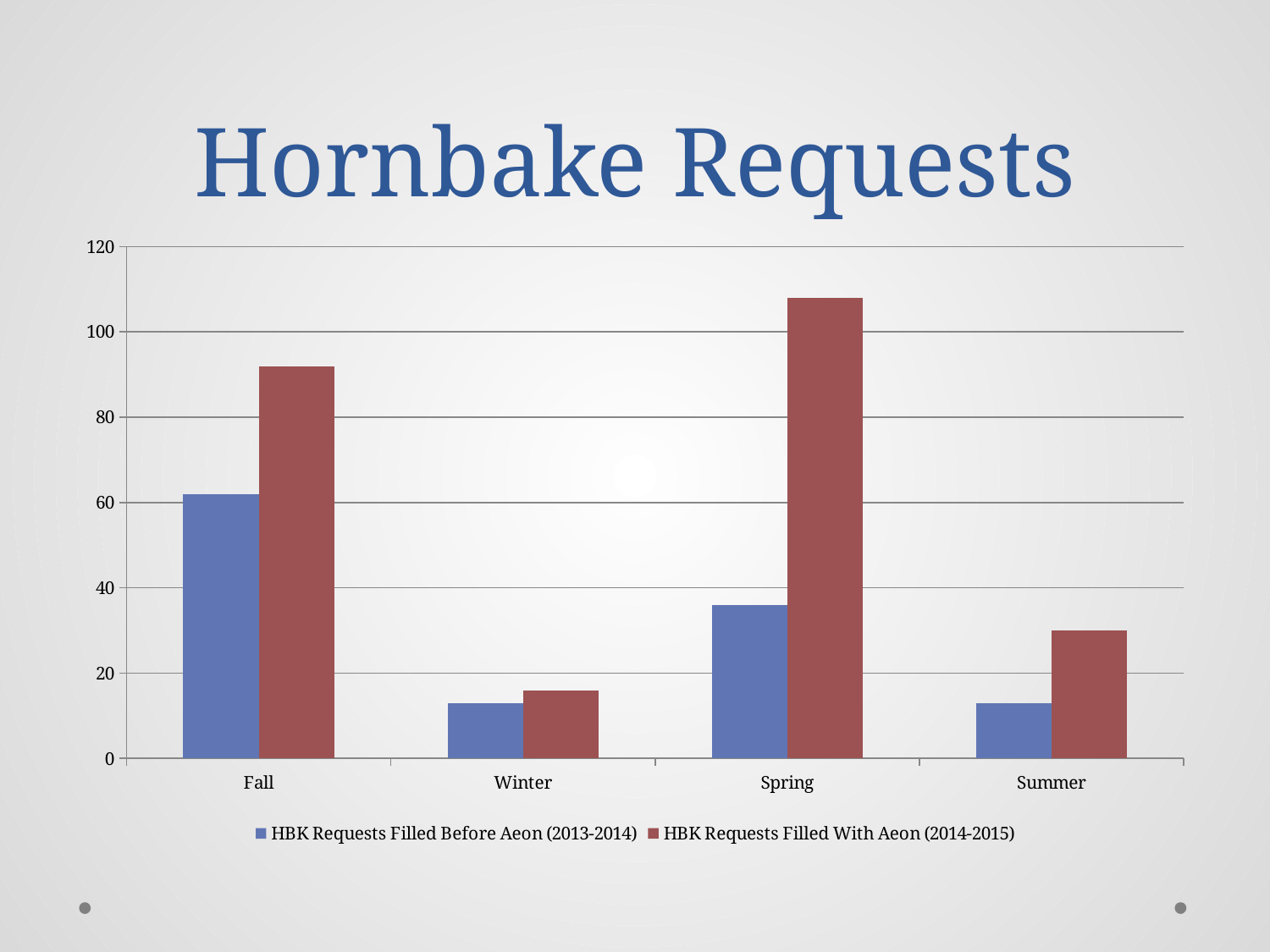
How many series does the legend list? 2 What kind of chart is shown on the slide? bar chart How many seasons are shown on the x axis? 4 Is the value for HBK Requests Filled With Aeon (2014-2015) in Spring greater or less than 100? greater Which season has the highest value for HBK Requests Filled Before Aeon (2013-2014)? Fall Which season has the highest value for HBK Requests Filled With Aeon (2014-2015)? Spring What is the title of the chart? Hornbake Requests Which season has the lowest value for HBK Requests Filled With Aeon (2014-2015)? Winter Which colour represents HBK Requests Filled With Aeon (2014-2015) in the chart? red Is the value for HBK Requests Filled Before Aeon (2013-2014) in Fall greater or less than 40? greater Is the value for HBK Requests Filled With Aeon (2014-2015) in Winter greater or less than 20? less Which is larger in Spring: HBK Requests Filled Before Aeon (2013-2014) or HBK Requests Filled With Aeon (2014-2015)? HBK Requests Filled With Aeon (2014-2015)